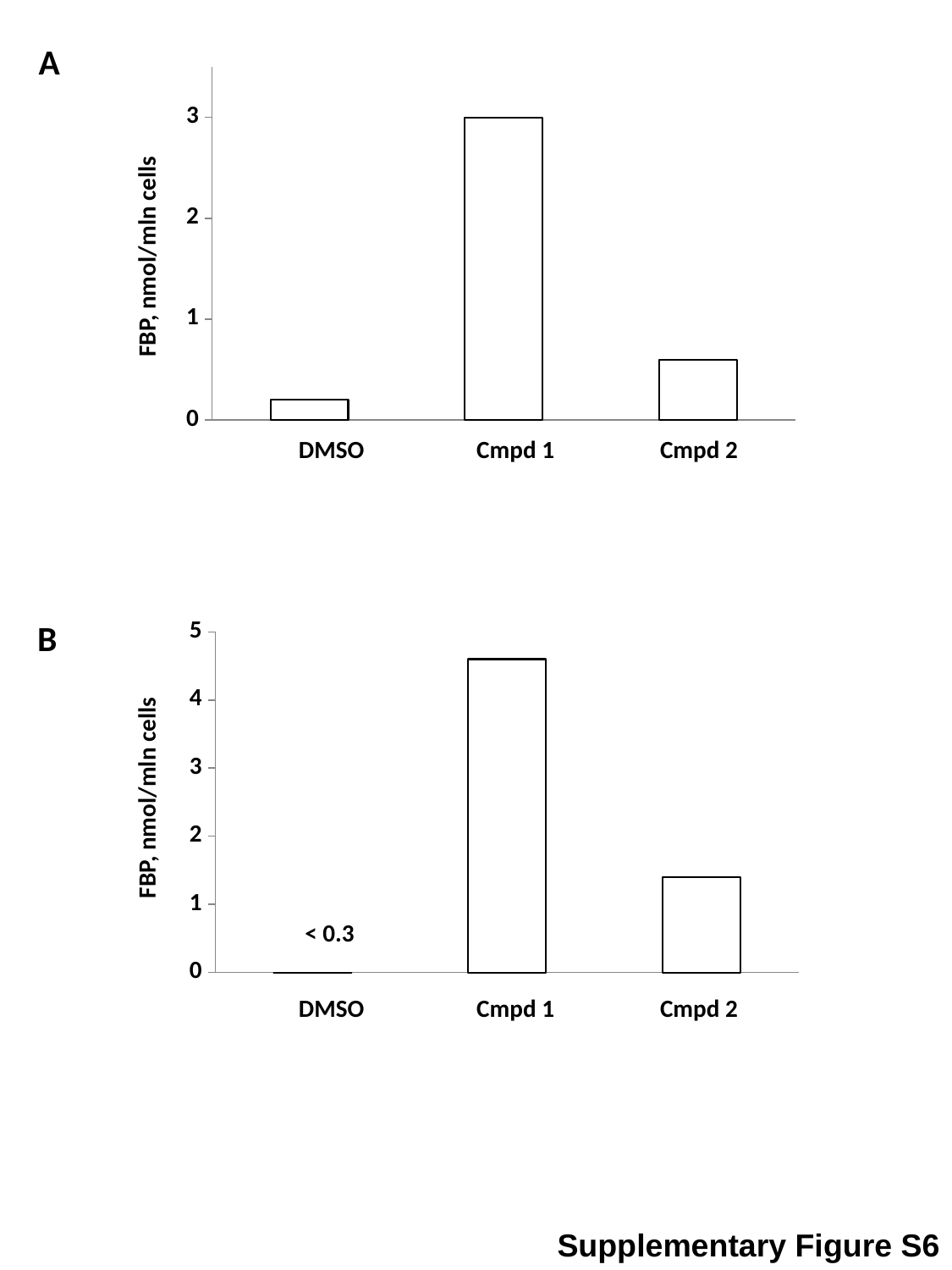
In chart A (top), which category has the highest FBP value? Cmpd 1 In chart B (bottom), which is larger, the value for Cmpd 1 or the value for Cmpd 2? Cmpd 1 In chart B (bottom), which category has the highest FBP value? Cmpd 1 What kind of chart is chart B (bottom)? bar chart In chart B (bottom), is the value for Cmpd 2 greater or less than 2? less In chart A (top), which category has the lowest FBP value? DMSO In chart B (bottom), what label is printed for the DMSO value? < 0.3 In chart B (bottom), is the value for Cmpd 1 greater or less than 4? greater In chart A (top), how many categories are shown on the x axis? 3 In chart A (top), is the value for Cmpd 1 greater or less than 2? greater In chart A (top), what is the FBP value for Cmpd 1 in nmol/mln cells? 3